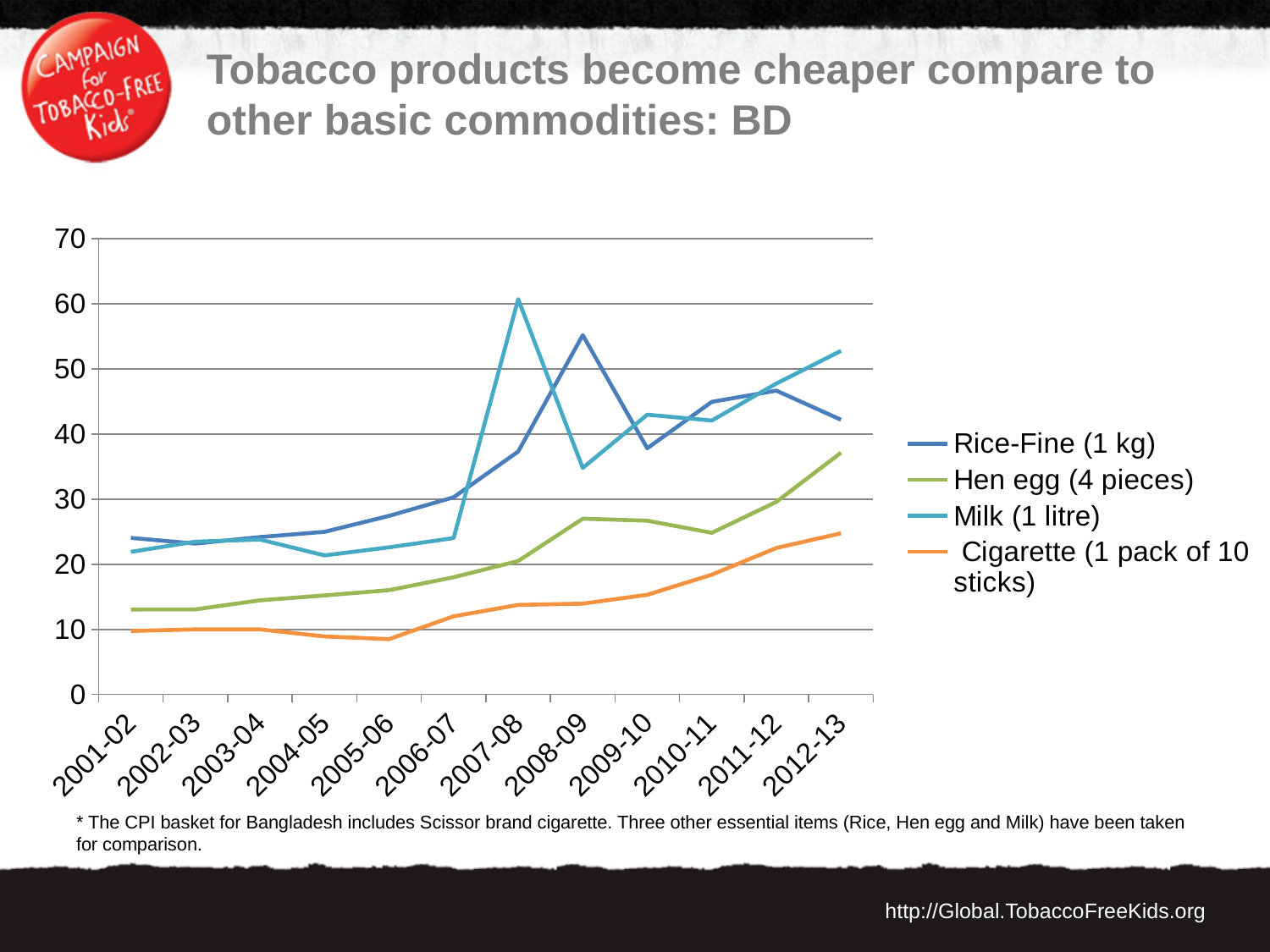
Which series has the highest value in 2008-09? Rice-Fine (1 kg) How many series does the legend list? 4 Which series has the lowest value in 2001-02? Cigarette (1 pack of 10 sticks) Is the value for Cigarette (1 pack of 10 sticks) in 2012-13 greater or less than 30? less Does the Hen egg (4 pieces) line rise or fall from 2001-02 to 2012-13? rise How many fiscal years are shown along the x axis? 12 Is the value for Milk (1 litre) in 2007-08 greater or less than 50? greater What is the title of the slide containing the chart? Tobacco products become cheaper compare to other basic commodities: BD What kind of chart is shown on the slide? line chart Is the value for Hen egg (4 pieces) in 2005-06 greater or less than 20? less In 2012-13, which is higher: Milk (1 litre) or Rice-Fine (1 kg)? Milk (1 litre)